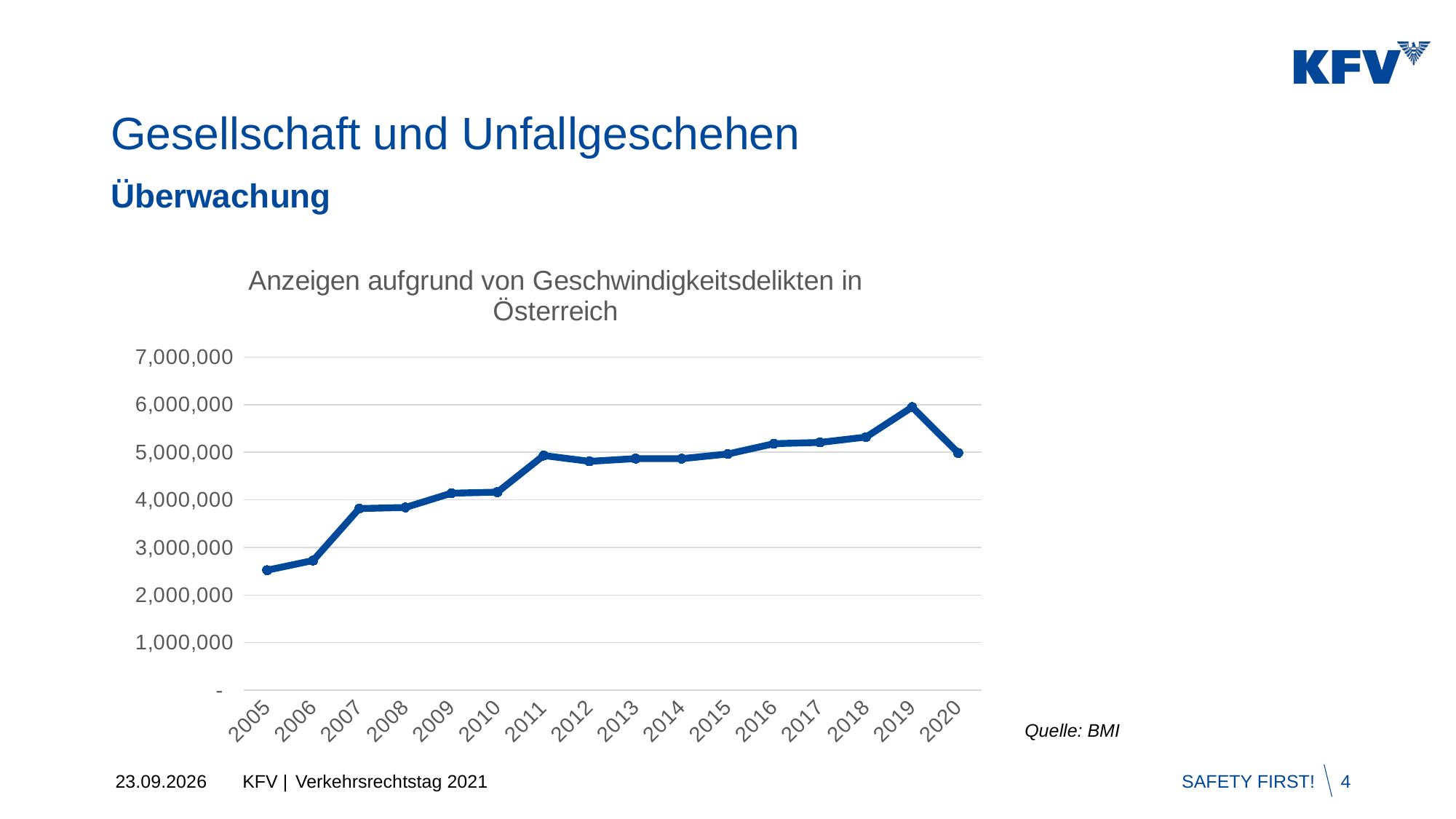
Is the value for 2018 greater or less than 5,000,000? greater What kind of chart is shown on the slide? line chart Which year has the larger value, 2019 or 2020? 2019 Does the value generally rise or fall from 2005 to 2019? rise Is the value for 2009 greater or less than 4,000,000? greater Which year has the highest value in the chart? 2019 Is the value for 2005 greater or less than 3,000,000? less How many years are plotted on the x axis of the chart? 16 Which year has the lowest value in the chart? 2005 What is the title of the chart? Anzeigen aufgrund von Geschwindigkeitsdelikten in Österreich